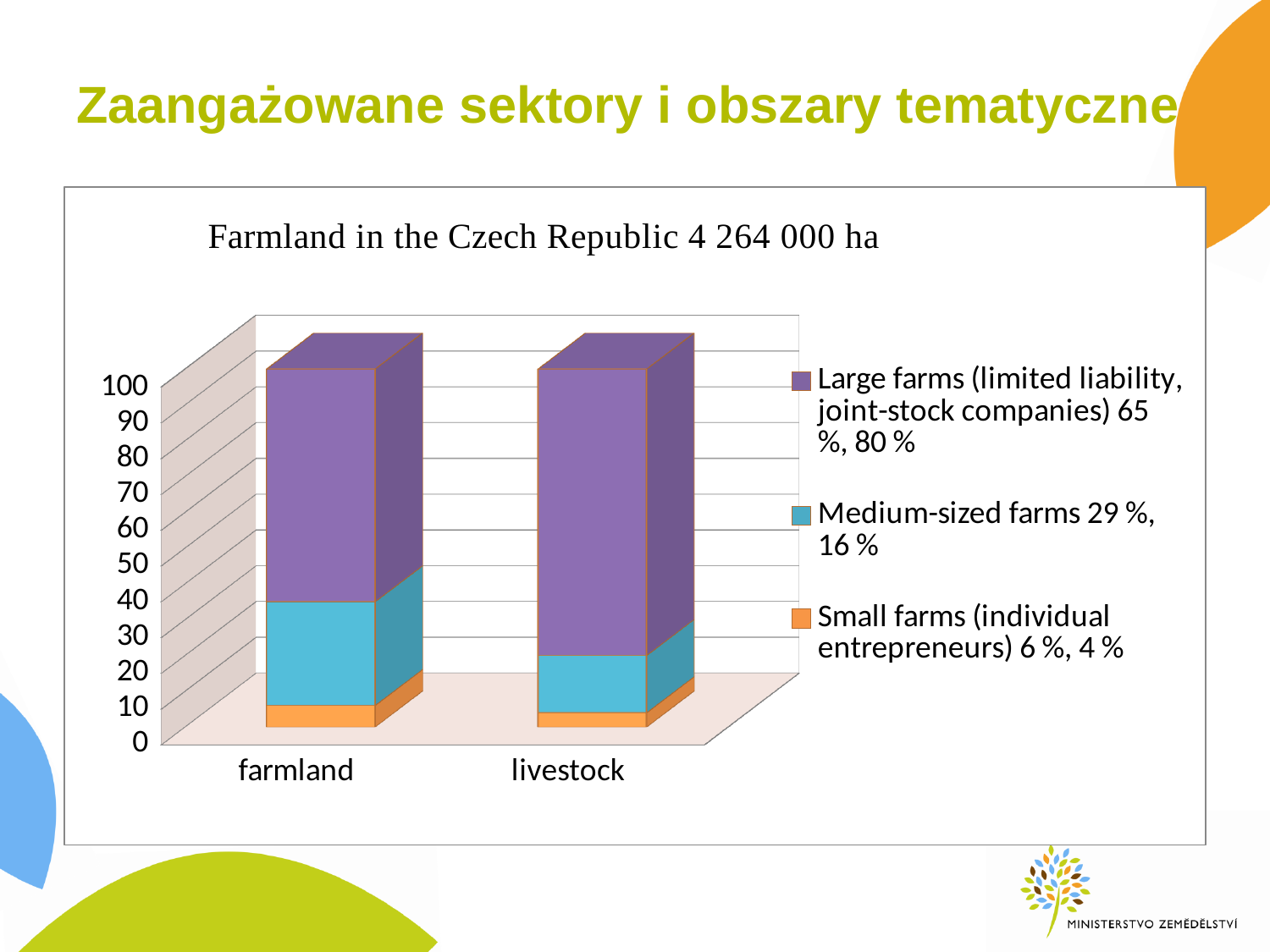
Which colour represents small farms (individual entrepreneurs) in the chart? Orange According to the legend, what share do large farms (limited liability, joint-stock companies) have of farmland? 65 % According to the legend, what share do large farms (limited liability, joint-stock companies) have of livestock? 80 % What is the difference between the medium-sized farms share for farmland and for livestock? 13 % What is the title of the chart? Farmland in the Czech Republic 4 264 000 ha According to the legend, what share do small farms (individual entrepreneurs) have of livestock? 4 % According to the legend, what share do medium-sized farms have of farmland? 29 % How many categories are shown on the x axis of the chart? 2 How many series does the chart legend list? 3 Which category has the larger share for large farms, farmland or livestock? livestock What kind of chart is shown on the slide? Stacked bar chart